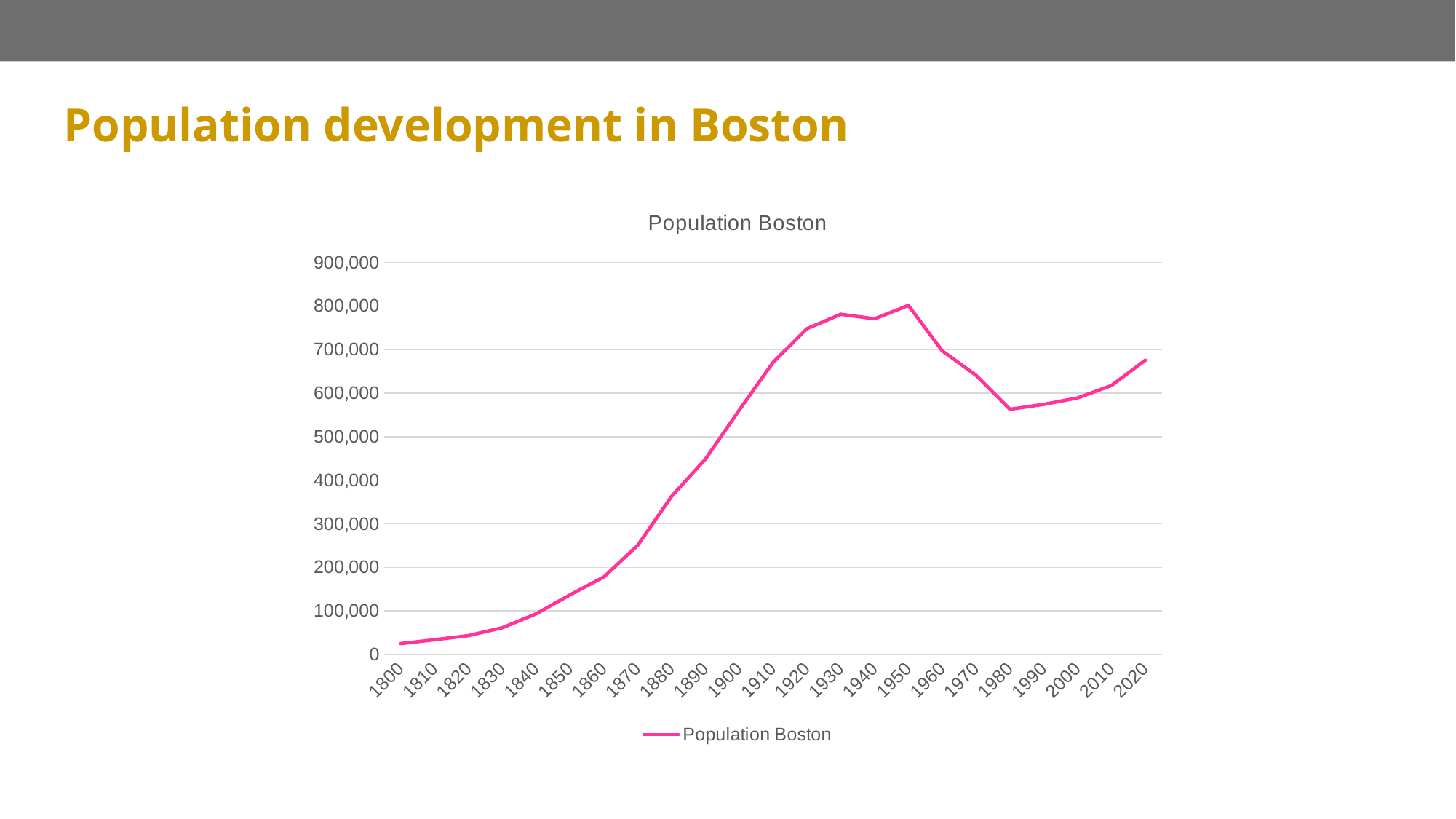
Is the population value for 1860 greater or less than 200,000? less How many series does the legend list? 1 How many years are plotted along the x axis? 23 Is the population value for 1900 greater or less than 500,000? greater In which year does the population of Boston reach its highest value? 1950 Which year has the larger population, 1920 or 2020? 1920 Is the population value for 1920 greater or less than 700,000? greater What kind of chart is shown on the slide? line chart In which year is the population of Boston lowest? 1800 What is the title of the chart? Population Boston Does the population of Boston rise or fall between 1950 and 1980? fall